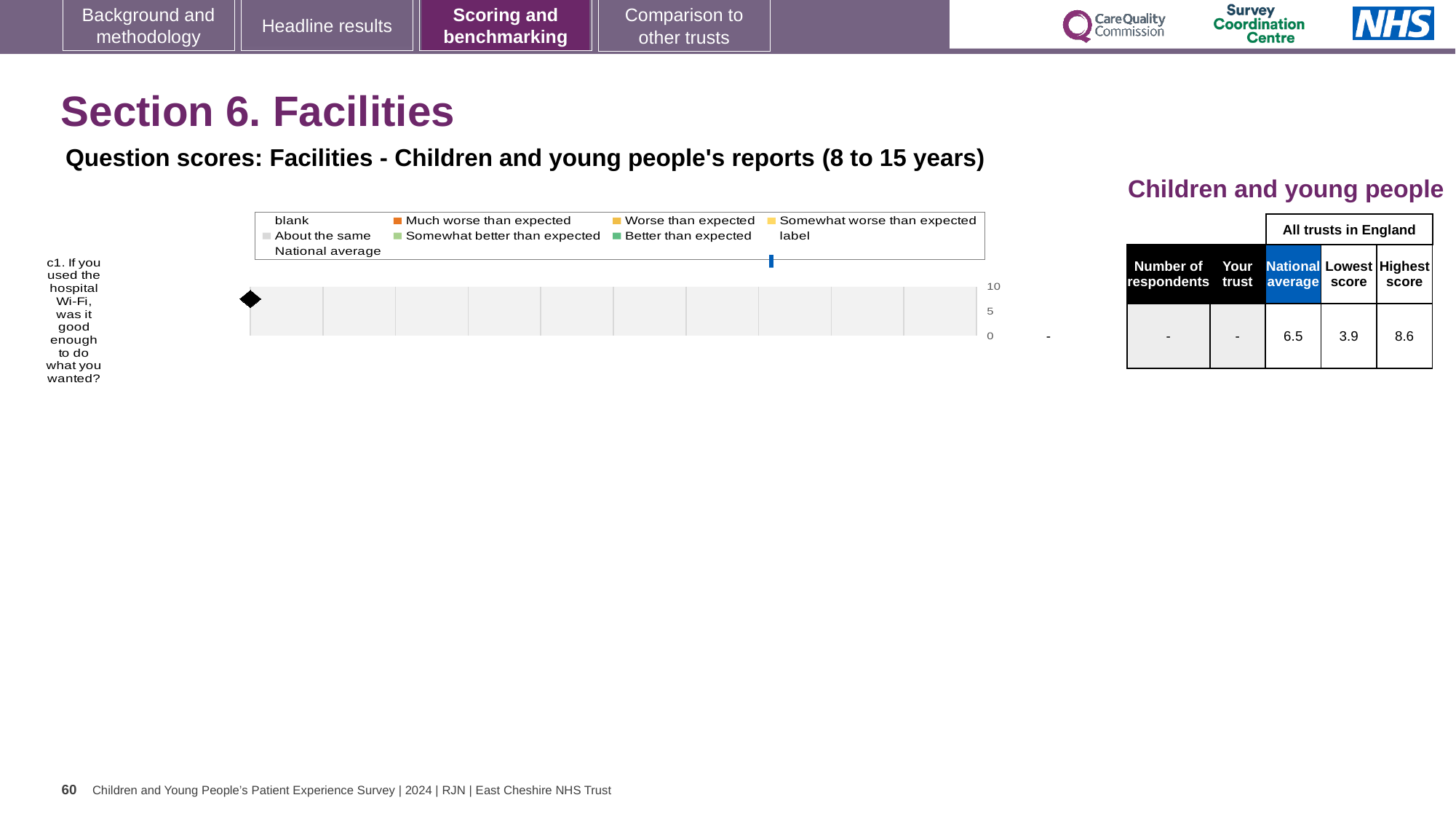
What kind of chart is shown on the slide? bar chart In the table next to the chart, what is the difference between the highest score and the lowest score for question c1? 4.7 In the table next to the chart, is the national average score for question c1 greater or less than 5? greater What is the highest value shown on the chart's value axis? 10 What value is printed for the trust's score on question c1 on the chart? - In the table next to the chart, what is the national average score for question c1? 6.5 In the table next to the chart, what is the highest score among all trusts in England for question c1? 8.6 In the table next to the chart, what is the lowest score among all trusts in England for question c1? 3.9 What is the label of the single category on the chart? c1. If you used the hospital Wi-Fi, was it good enough to do what you wanted? How many question categories are plotted on the chart? 1